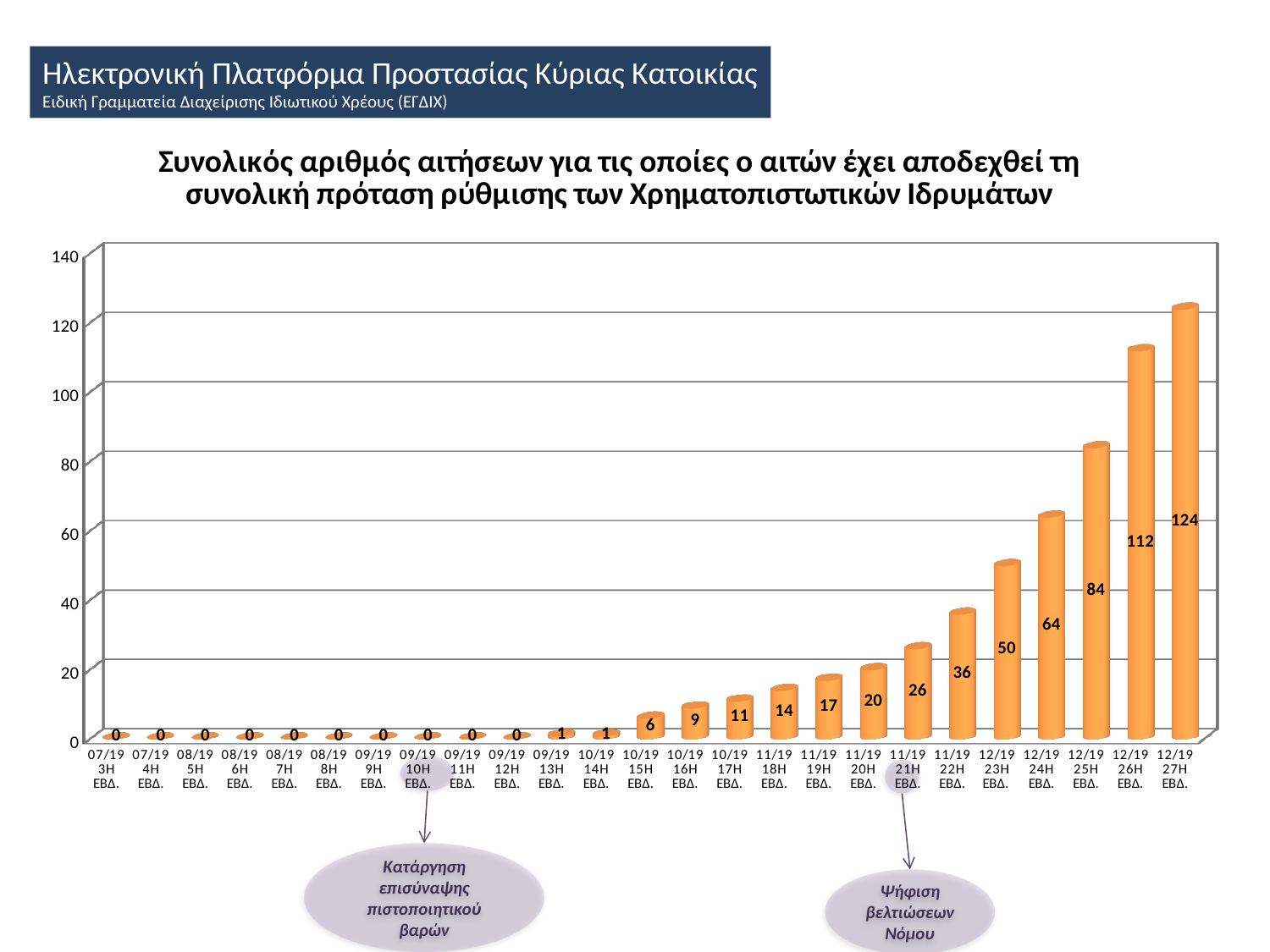
How many weeks have a value of 0? 10 What kind of chart is shown? bar chart How many weeks are shown on the x axis? 25 Which week has the highest value? 12/19 27Η ΕΒΔ. What is the value for 11/19 22Η ΕΒΔ.? 36 Do the values rise or fall from left to right along the x axis? rise Which is larger, the value for 11/19 20Η ΕΒΔ. or the value for 11/19 21Η ΕΒΔ.? 11/19 21Η ΕΒΔ. What is the difference between the values for 12/19 24Η ΕΒΔ. and 12/19 23Η ΕΒΔ.? 14 What is the difference between the values for 12/19 26Η ΕΒΔ. and 12/19 25Η ΕΒΔ.? 28 What is the value for 12/19 27Η ΕΒΔ.? 124 What is the value for 10/19 16Η ΕΒΔ.? 9 Is the value for 12/19 26Η ΕΒΔ. greater or less than 100? greater